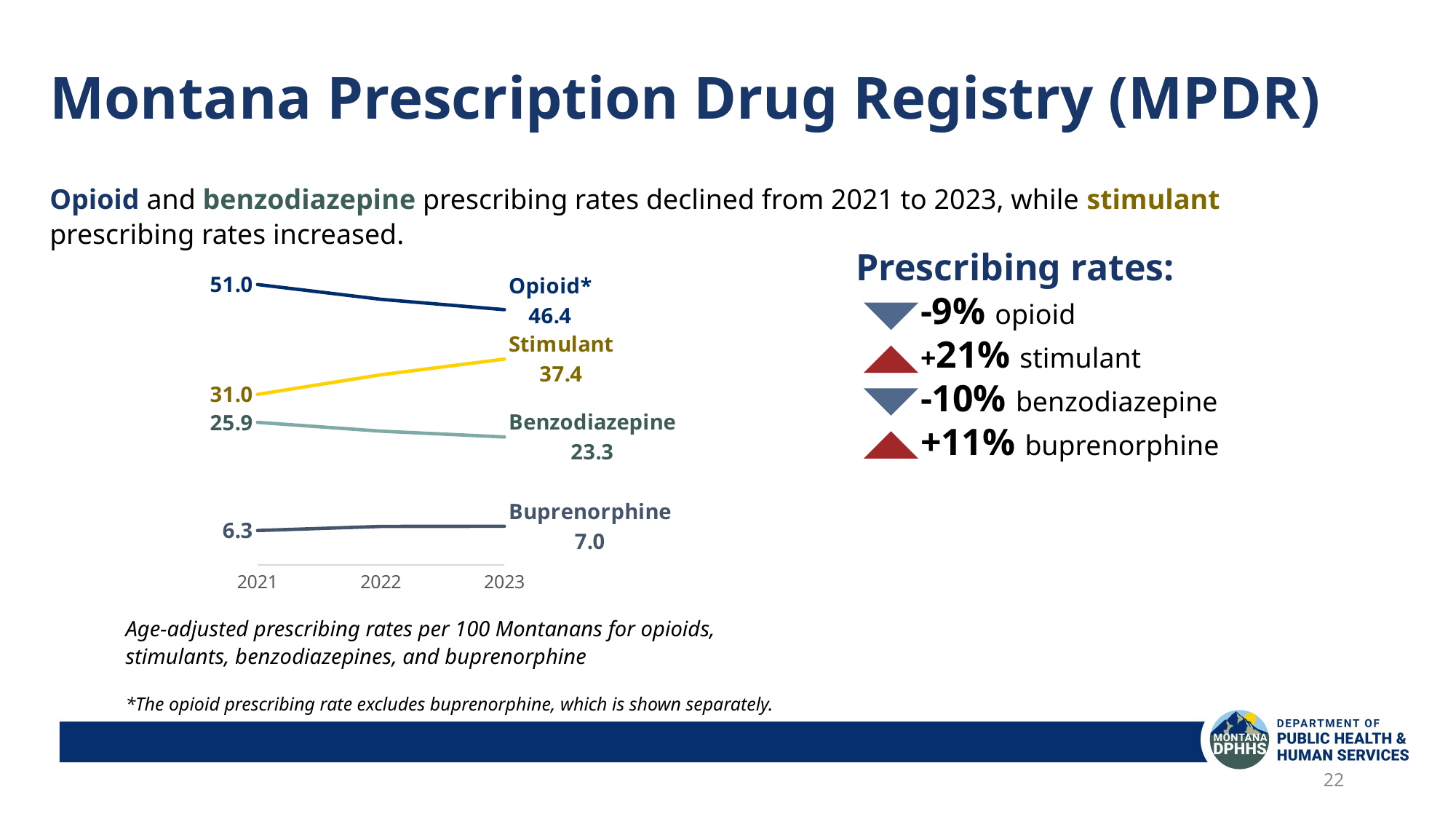
What was the buprenorphine prescribing rate in 2021? 6.3 In 2021, which was higher: the stimulant rate or the benzodiazepine rate? Stimulant Which drug category had the highest prescribing rate in 2023? Opioid What was the opioid prescribing rate in 2021? 51.0 Did the stimulant prescribing rate rise or fall from 2021 to 2023? Rise By how much did the opioid prescribing rate change from 2021 to 2023? 4.6 What was the benzodiazepine prescribing rate in 2023? 23.3 What is the difference between the stimulant and benzodiazepine prescribing rates in 2023? 14.1 How many drug categories are plotted in the chart? 4 What was the stimulant prescribing rate in 2023? 37.4 Which drug category had the lowest prescribing rate in 2021? Buprenorphine What type of chart is shown on the slide? Line chart